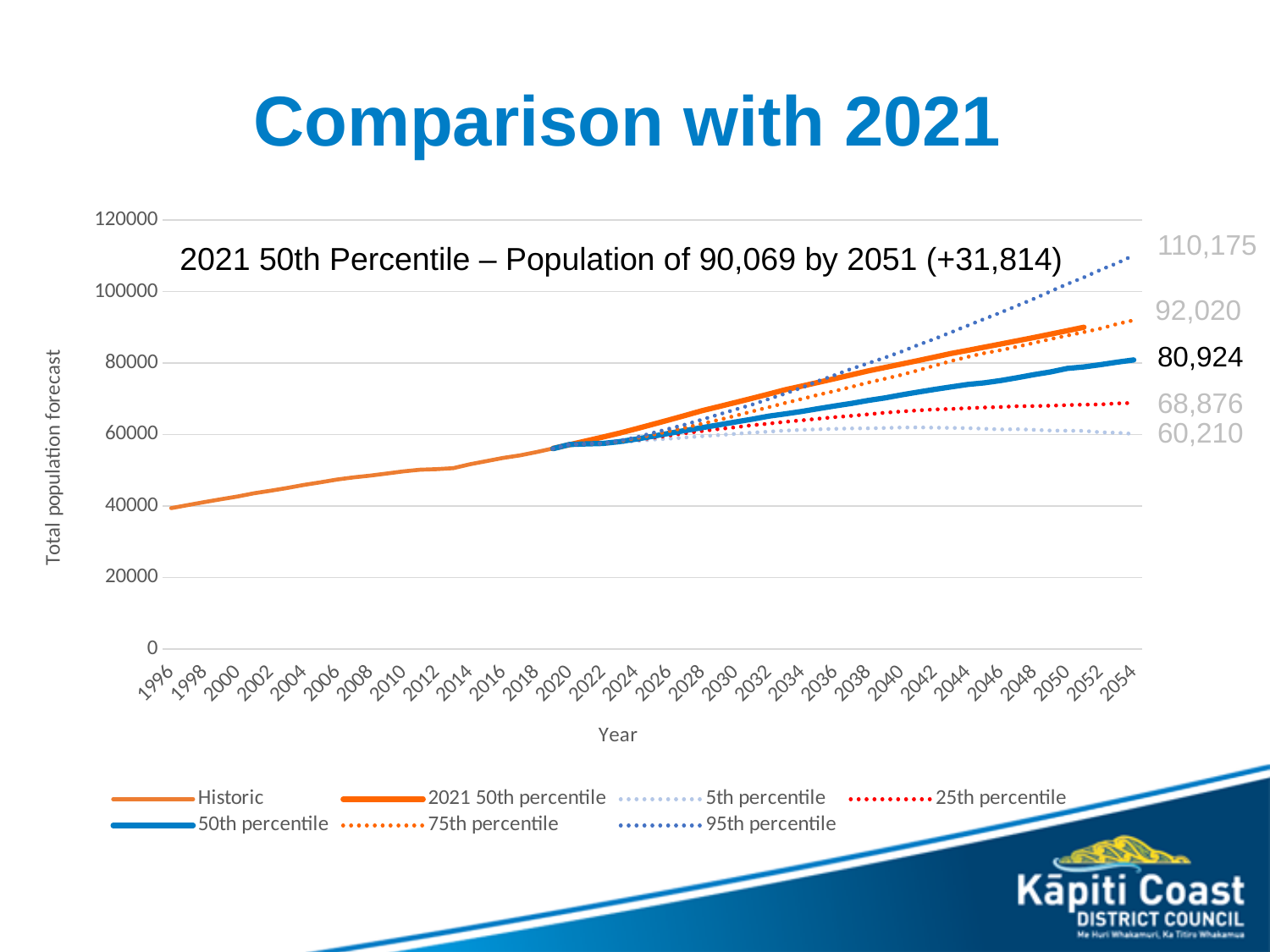
What is the end value labelled for the 50th percentile series? 80,924 What is the title of the vertical axis? Total population forecast What is the end value labelled for the 95th percentile series? 110,175 Does the Historic series rise or fall from 1996 to 2020? rise Which series ends at the lowest value on the chart? 5th percentile According to the annotation on the chart, what population does the 2021 50th percentile reach by 2051? 90,069 Which series ends at the highest value on the chart? 95th percentile What is the difference between the labelled end values of the 95th percentile and the 5th percentile series? 49,965 What kind of chart is shown on the slide? line chart What is the difference between the labelled end values of the 75th percentile and the 50th percentile series? 11,096 What is the end value labelled for the 5th percentile series? 60,210 How many series does the legend list? 7